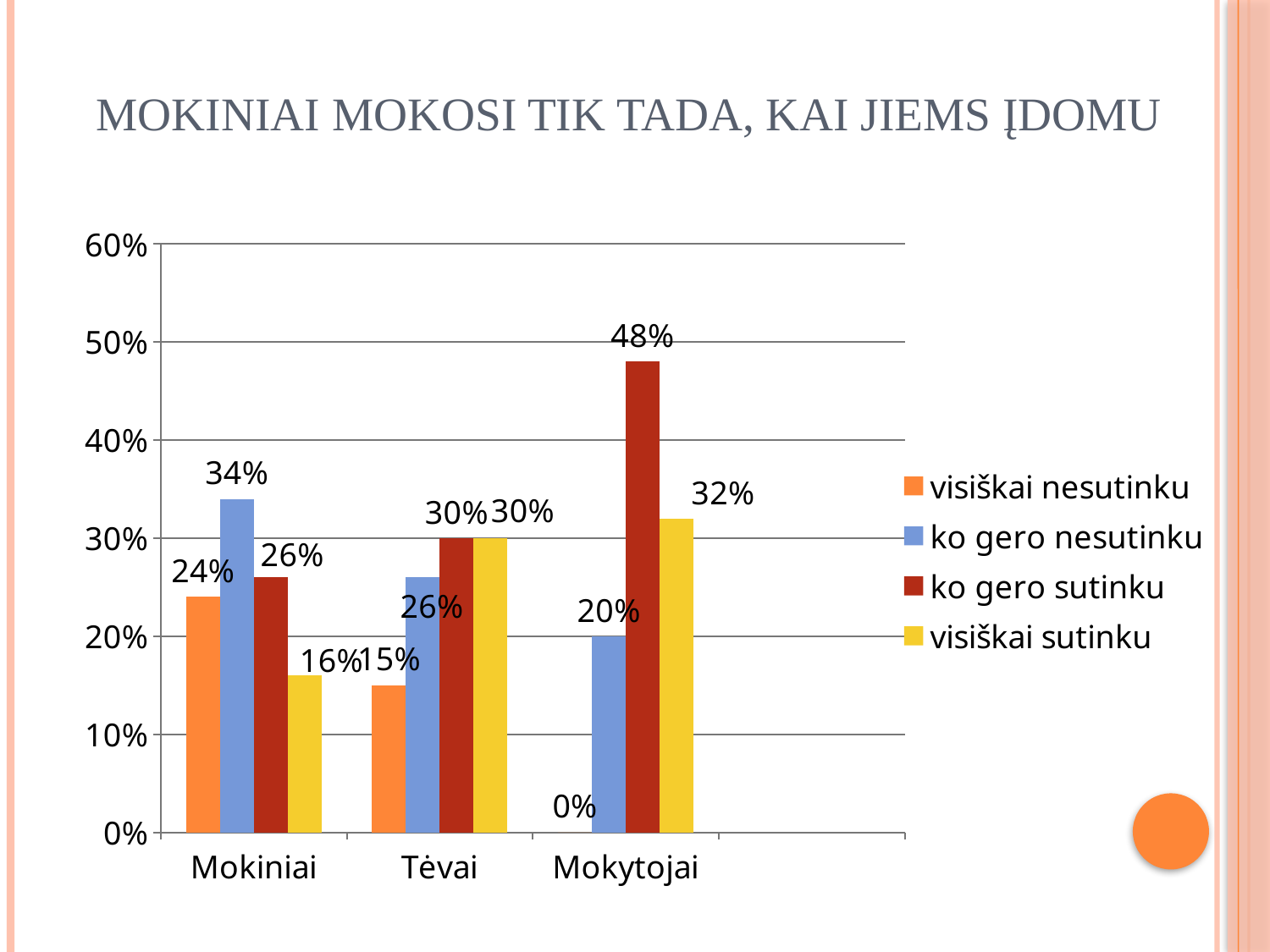
What is the value for 'visiškai nesutinku' in the Mokiniai category? 24% Which category has the lowest value for 'visiškai nesutinku'? Mokytojai What is the value for 'visiškai sutinku' in the Tėvai category? 30% Which is larger: 'visiškai sutinku' for Mokiniai or 'visiškai sutinku' for Mokytojai? Mokytojai What is the value for 'visiškai nesutinku' in the Mokytojai category? 0% What is the value for 'ko gero sutinku' in the Mokytojai category? 48% What is the title of the chart on the slide? MOKINIAI MOKOSI TIK TADA, KAI JIEMS ĮDOMU How many series does the legend list? 4 How many categories are shown on the x axis? 3 Which category has the highest value for 'ko gero sutinku'? Mokytojai What kind of chart is shown on the slide? bar chart What is the difference between the 'ko gero nesutinku' values for Mokiniai and Mokytojai? 14%